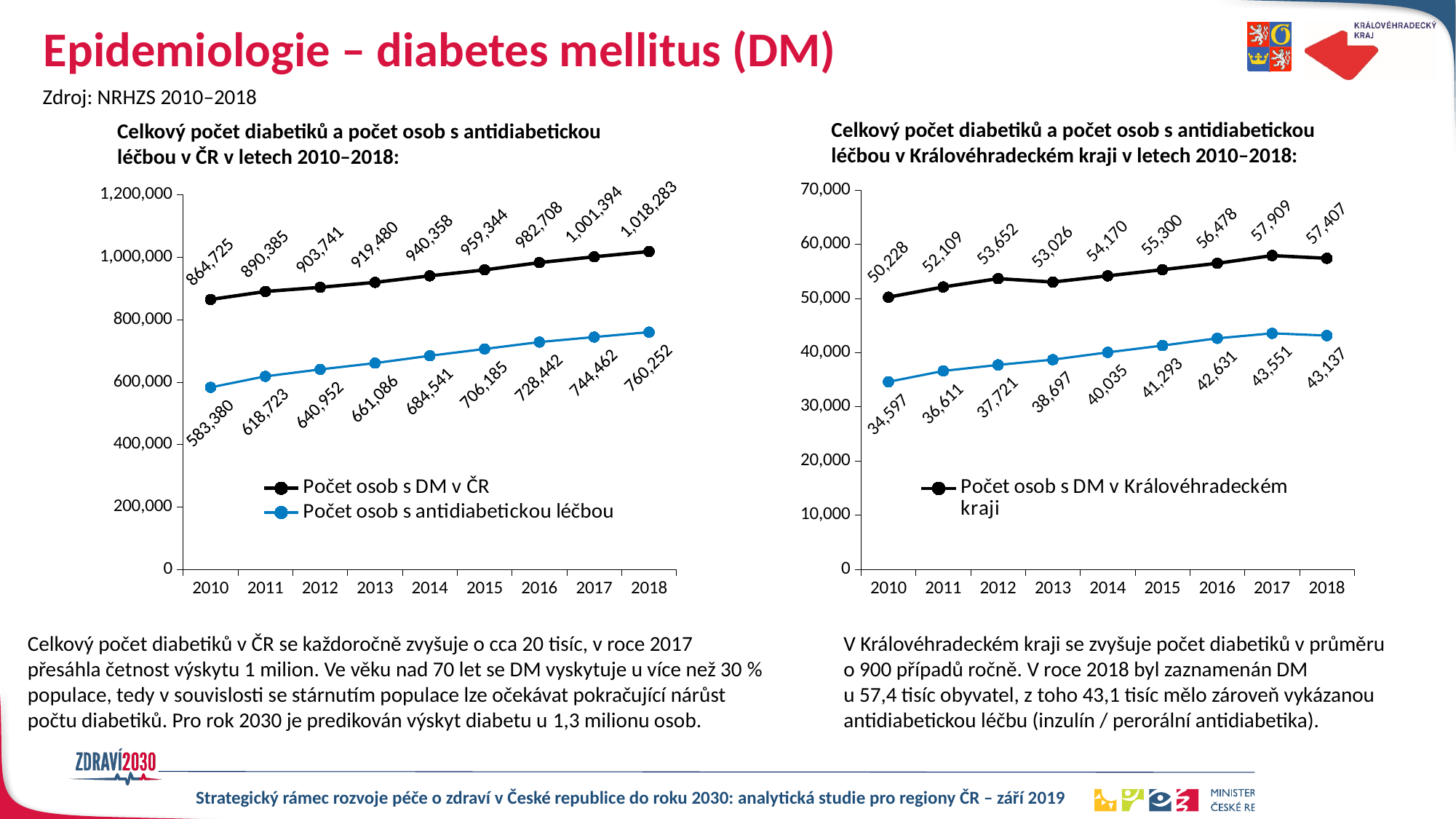
In the left chart (ČR), what is the value for Počet osob s DM v ČR in 2017? 1,001,394 How many years are shown on the x axis of the left chart (ČR)? 9 In the right chart (Královéhradecký kraj), which is larger for the upper (black) series: the 2012 value or the 2013 value? 2012 In the right chart (Královéhradecký kraj), what is the value of the lower (blue) series in 2014? 40,035 In the left chart (ČR), is the value for Počet osob s DM v ČR in 2010 greater or less than 800,000? greater What type of chart is the right chart (Královéhradecký kraj)? Line chart In the right chart (Královéhradecký kraj), in which year is the upper (black) series highest? 2017 In the left chart (ČR), what is the difference between Počet osob s DM v ČR and Počet osob s antidiabetickou léčbou in 2018? 258,031 In the left chart (ČR), what is the value for Počet osob s antidiabetickou léčbou in 2010? 583,380 In the left chart (ČR), in which year is Počet osob s antidiabetickou léčbou lowest? 2010 In the right chart (Královéhradecký kraj), what is the value of the upper (black) series in 2018? 57,407 How many series does the legend of the left chart (ČR) list? 2